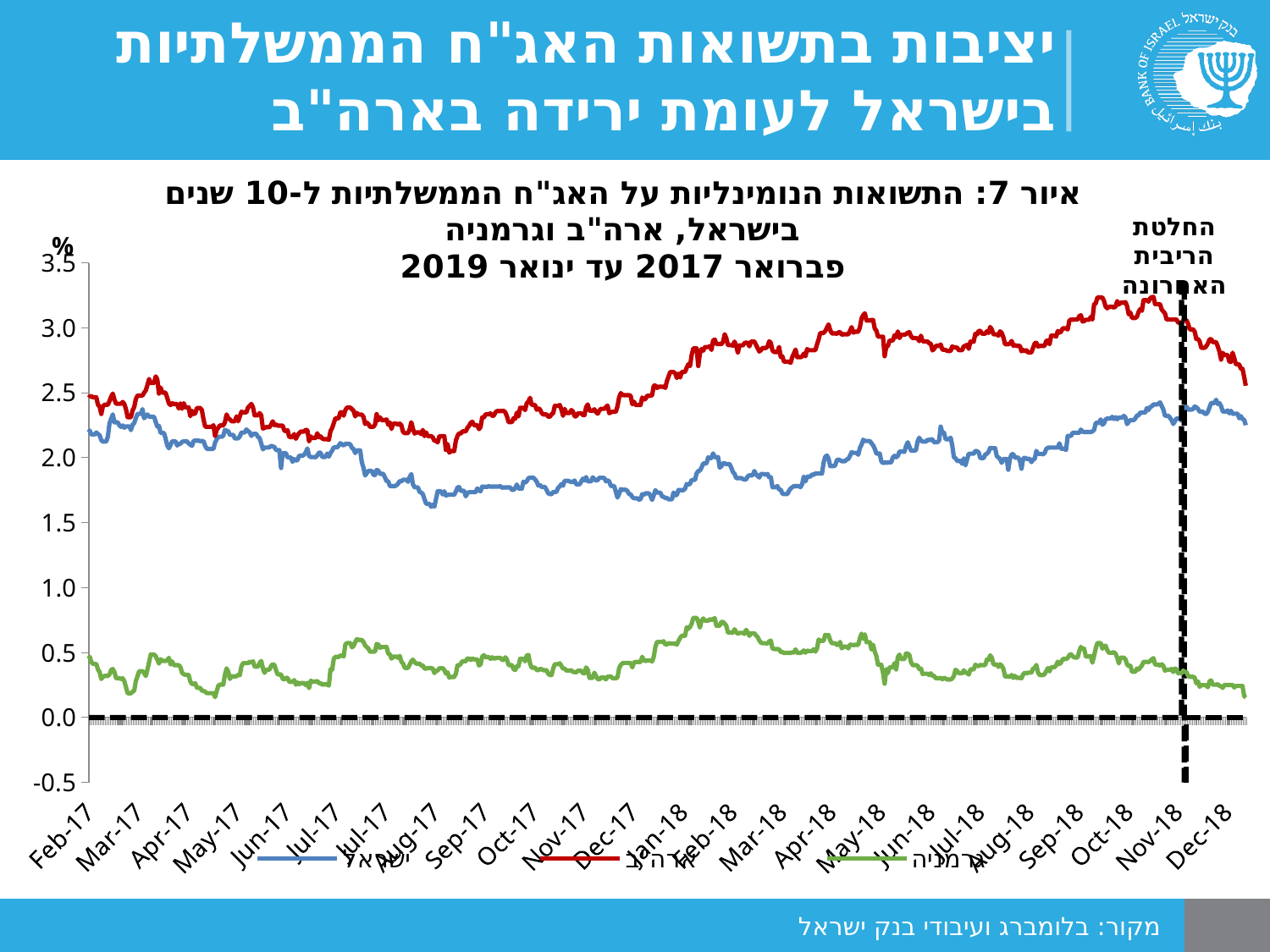
Does the value for ארה"ב rise or fall from Feb-17 to Oct-18? rise In Dec-18, which is larger: the value for ישראל or the value for ארה"ב? ארה"ב What does the vertical dashed line near the right of the chart mark? החלטת הריבית האחרונה Is the value for ארה"ב in Feb-18 greater or less than 2.5? greater Is the value for ארה"ב in Oct-18 greater or less than 3.0? greater What kind of chart is shown on the slide? Line chart Which series has the lowest yields throughout the period shown? גרמניה How many series does the legend list? 3 Which colour is used for the ישראל series? Blue Is the value for גרמניה at any point greater or less than 1.0? less Which series has the highest yields throughout the period shown? ארה"ב